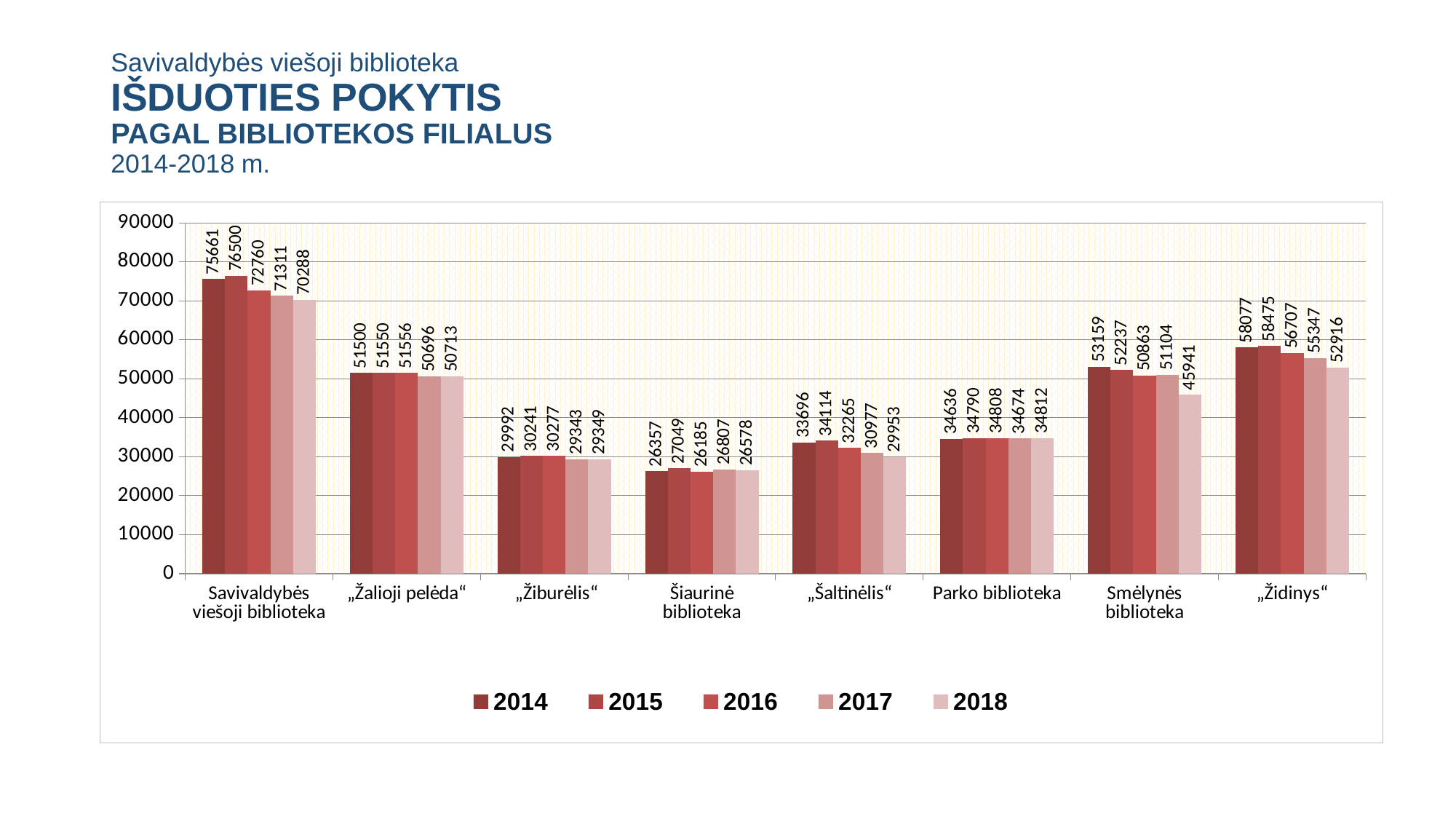
Is the value for Parko biblioteka in 2016 greater or less than 30000? greater Which library has the highest value in 2014? Savivaldybės viešoji biblioteka What kind of chart is shown on the slide? bar chart What is the value for Smėlynės biblioteka in 2018? 45941 Which is larger in 2014: Smėlynės biblioteka or „Židinys“? „Židinys“ How many libraries (categories) are shown on the x axis? 8 What is the value for „Žalioji pelėda“ in 2016? 51556 What is the difference between the 2015 and 2018 values for „Šaltinėlis“? 4161 Which library has the lowest value in 2018? Šiaurinė biblioteka What is the value for „Židinys“ in 2014? 58077 How many series does the legend list? 5 What is the difference between the 2014 and 2018 values for Savivaldybės viešoji biblioteka? 5373